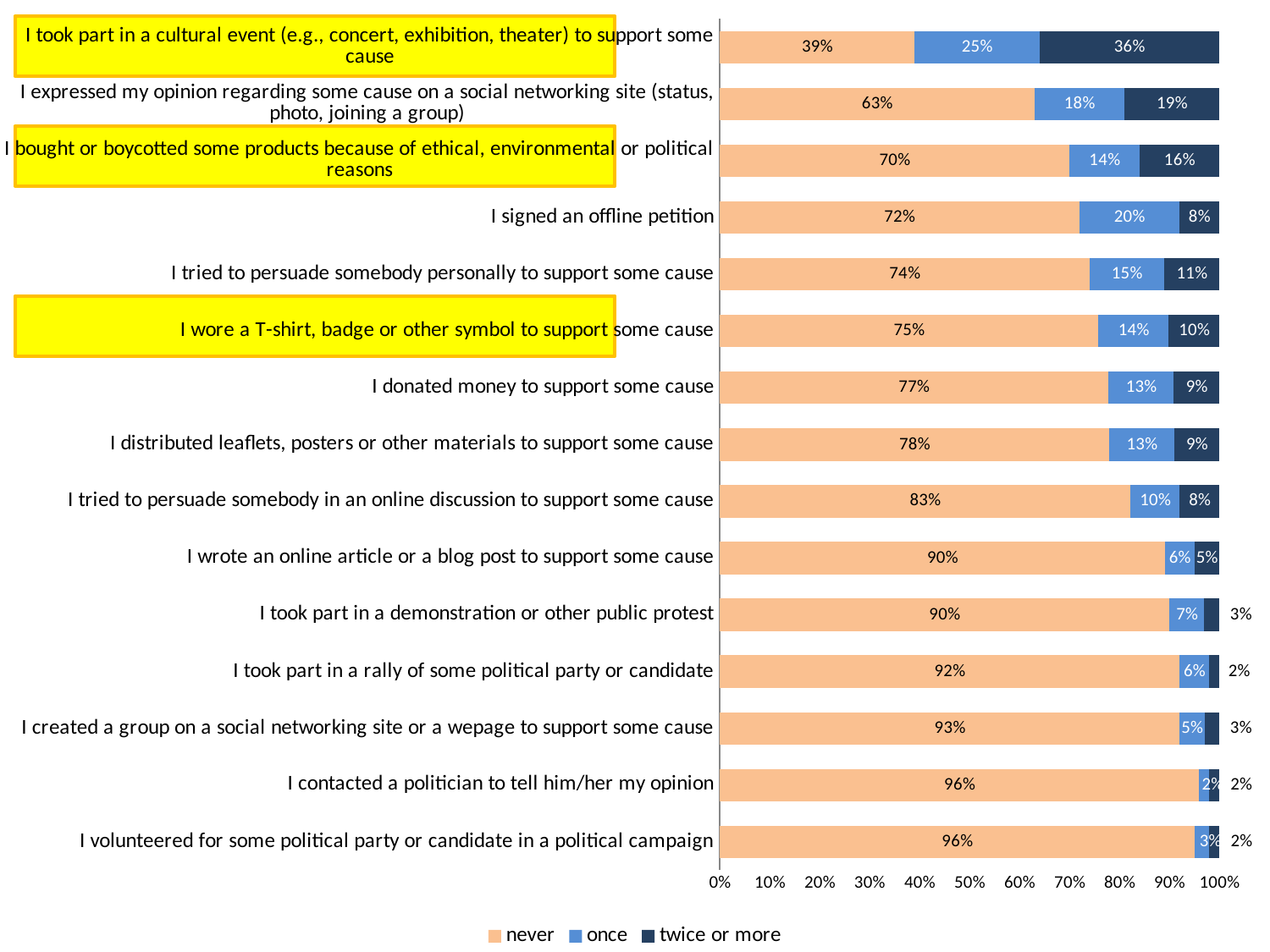
How many series does the legend list? 3 How many activities (categories) are shown in the chart? 15 Which series is shown in the darkest colour in the legend? twice or more What is the "never" value for "I contacted a politician to tell him/her my opinion"? 96% What is the "twice or more" value for "I expressed my opinion regarding some cause on a social networking site (status, photo, joining a group)"? 19% What is the difference between the "never" values for "I bought or boycotted some products because of ethical, environmental or political reasons" and "I wore a T-shirt, badge or other symbol to support some cause"? 5% Which activity has the lowest "never" value? I took part in a cultural event (e.g., concert, exhibition, theater) to support some cause What kind of chart is shown on the slide? Stacked bar chart Which activity has the highest "twice or more" value? I took part in a cultural event (e.g., concert, exhibition, theater) to support some cause What percentage of respondents answered "never" for "I took part in a cultural event (e.g., concert, exhibition, theater) to support some cause"? 39% What is the "once" value for "I signed an offline petition"? 20% Which is larger: the "once" value for "I tried to persuade somebody personally to support some cause" or the "once" value for "I donated money to support some cause"? I tried to persuade somebody personally to support some cause